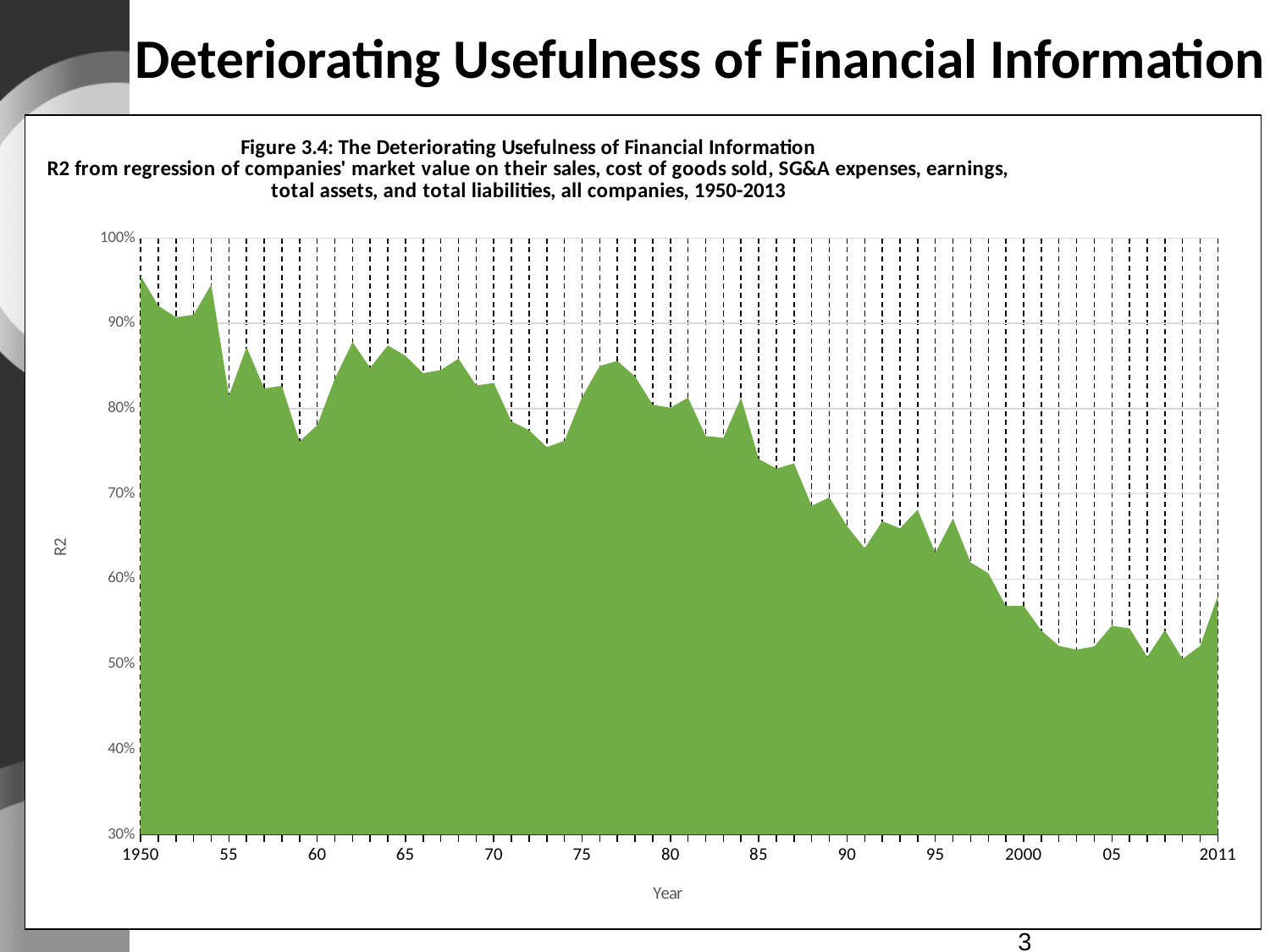
What is the label on the horizontal axis of the chart? Year What kind of chart is shown on the slide? Area chart Is the R2 value for 1990 greater or less than 70%? less Is the R2 value for 1965 greater or less than 80%? greater What is the label on the vertical axis of the chart? R2 Is the R2 value for 1985 greater or less than 80%? less Which year has the larger R2 value, 1950 or 2011? 1950 Overall, do the R2 values rise or fall from 1950 to 2011? Fall Which year has the larger R2 value, 1960 or 1990? 1960